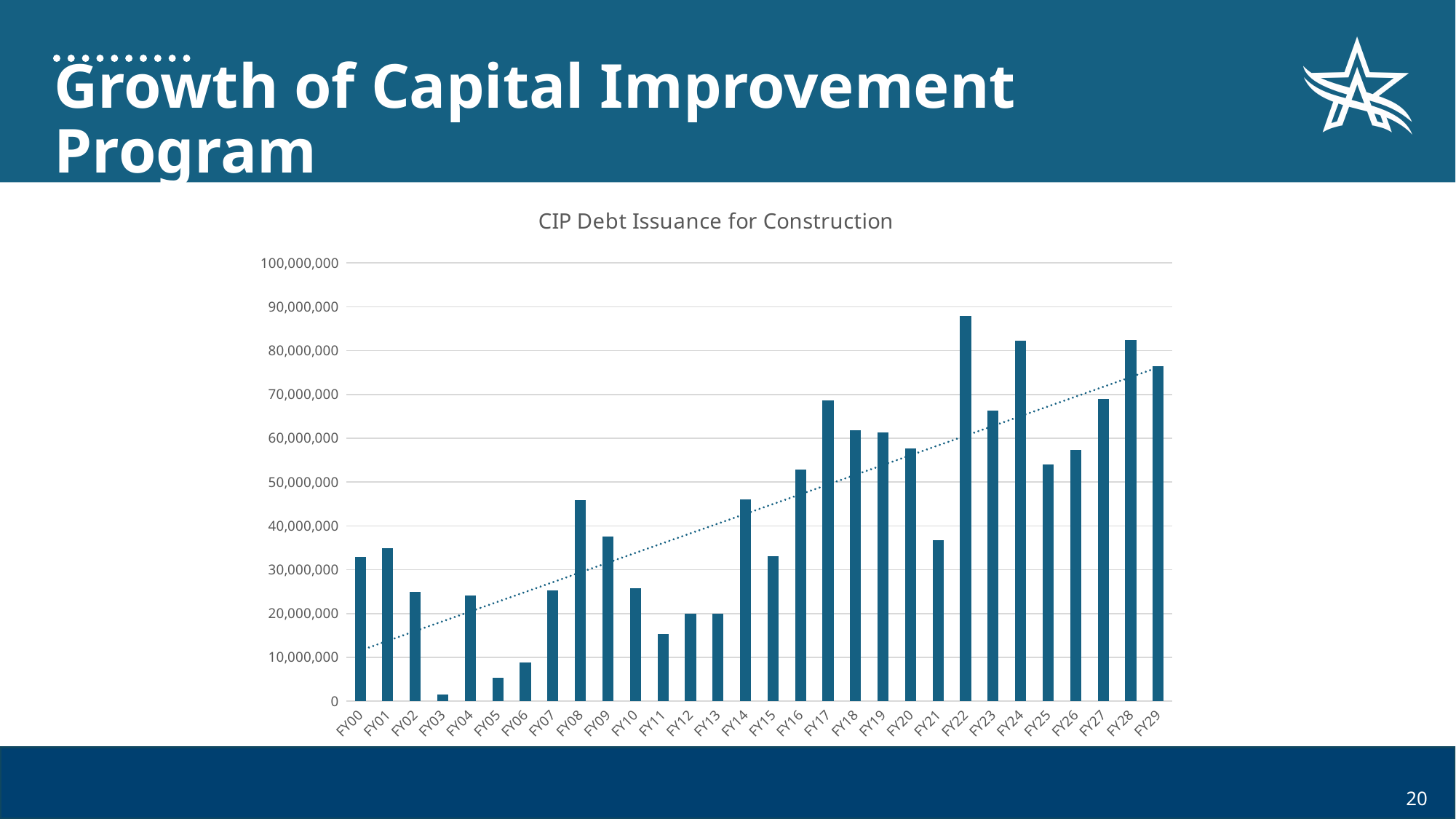
Which is larger, the value for FY08 or the value for FY09? FY08 How many fiscal years are plotted on the x axis? 30 Is the value for FY11 greater or less than 20,000,000? less Which fiscal year has the lowest CIP debt issuance for construction? FY03 Is the value for FY17 greater or less than 60,000,000? greater Does the dotted trend line rise or fall from FY00 to FY29? Rises Which fiscal year has the highest CIP debt issuance for construction? FY22 What type of chart is shown on the slide? Bar chart Which is larger, the value for FY24 or the value for FY25? FY24 What is the title of the chart? CIP Debt Issuance for Construction Is the value for FY22 greater or less than 80,000,000? greater